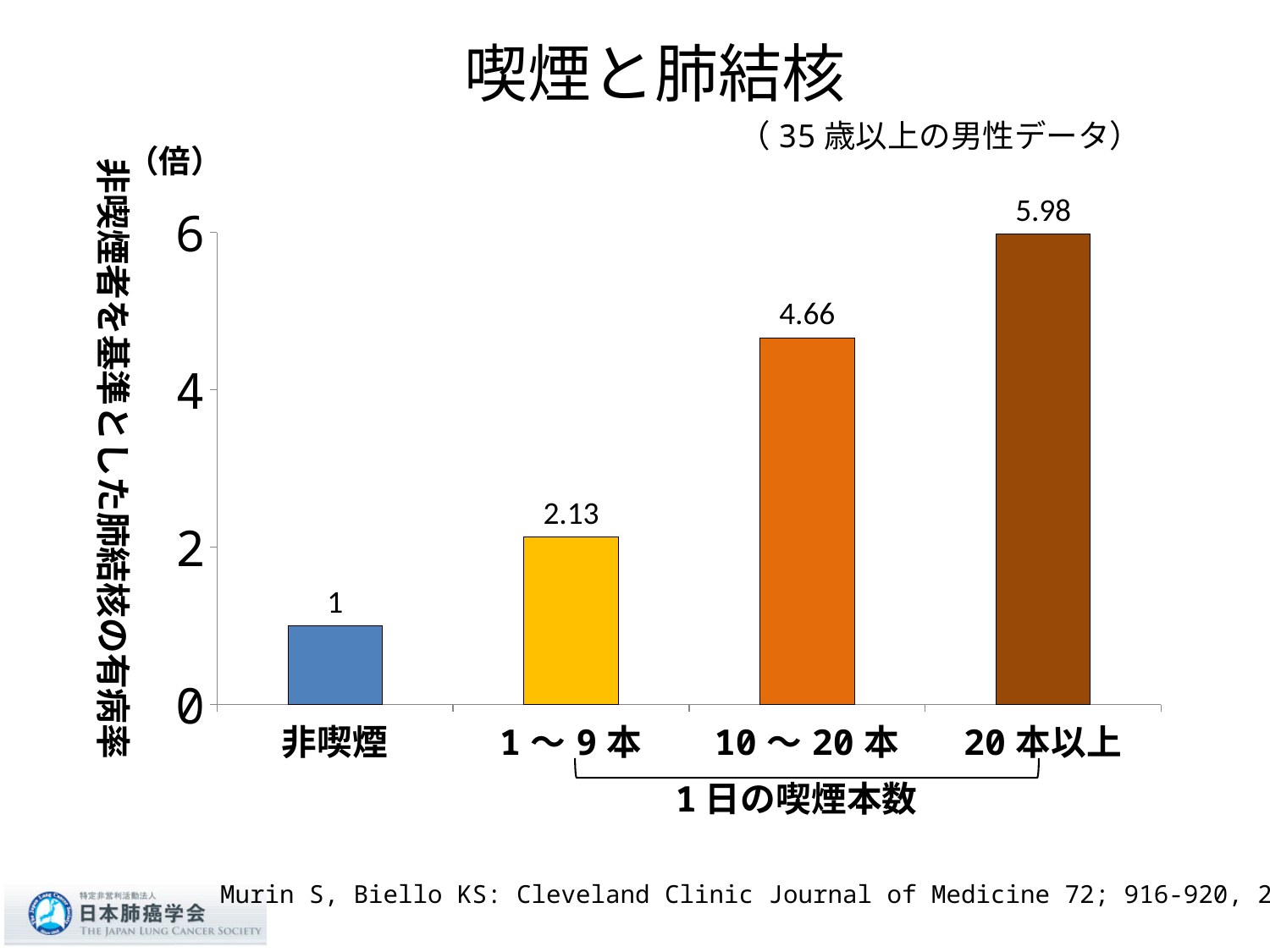
What is the value for 10～20本? 4.66 What is the difference between the values for 20本以上 and 10～20本? 1.32 Which is larger, the value for 10～20本 or the value for 1～9本? 10～20本 Which category has the lowest value? 非喫煙 What is the value for 20本以上? 5.98 How many categories are shown on the x axis? 4 Which category has the highest value? 20本以上 What is the difference between the values for 1～9本 and 非喫煙? 1.13 Do the values rise or fall from left to right along the x axis? rise What kind of chart is shown on the slide? bar chart What is the value for 1～9本? 2.13 What is the value for 非喫煙? 1